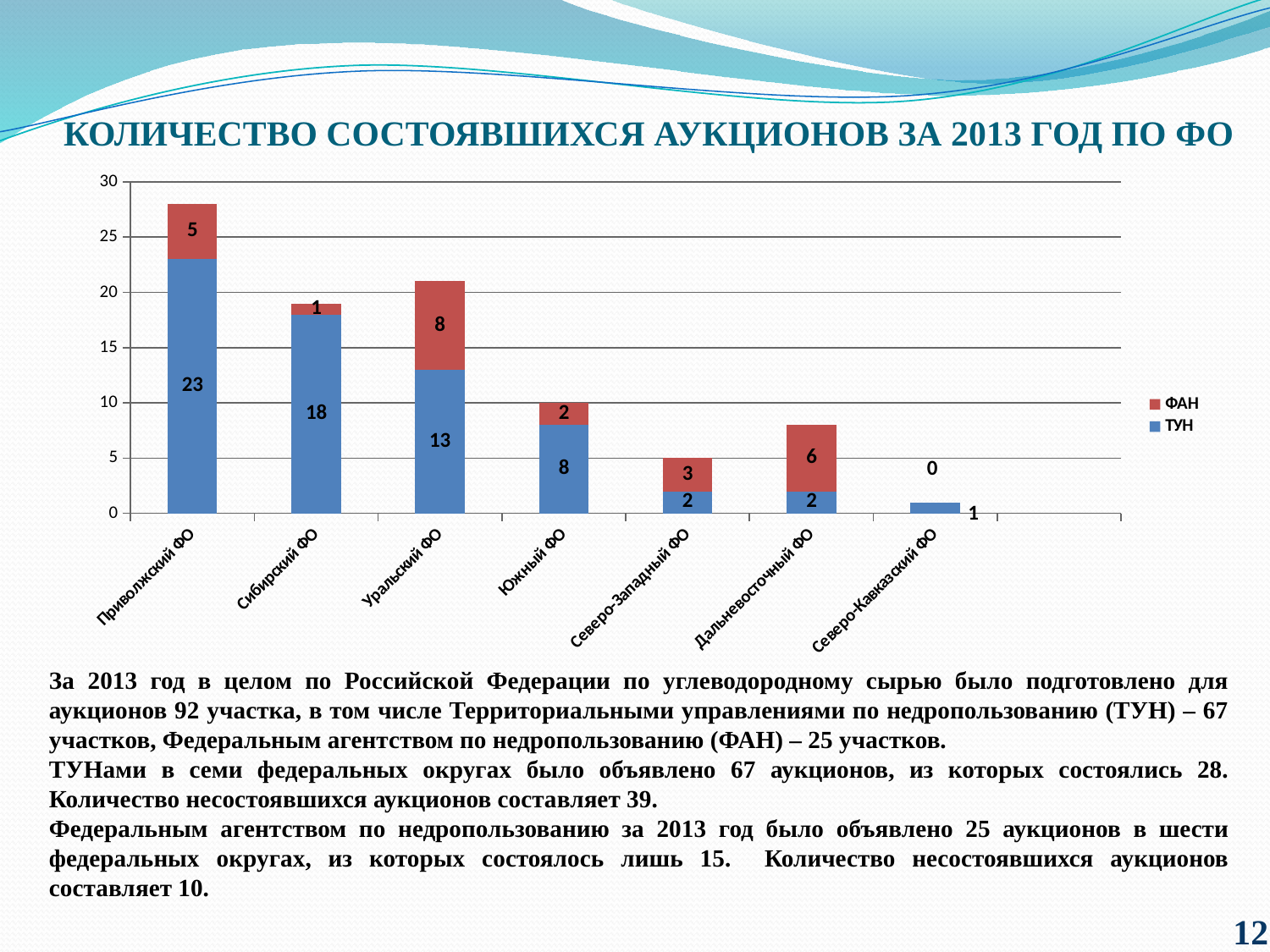
What is the ТУН value for Приволжский ФО? 23 Which federal district has the lowest ФАН value? Северо-Кавказский ФО Which is larger, the ФАН value for Дальневосточный ФО or the ФАН value for Южный ФО? Дальневосточный ФО What is the ФАН value for Уральский ФО? 8 What is the total of the stacked bar for Уральский ФО? 21 What is the ТУН value for Дальневосточный ФО? 2 Which federal district has the highest ТУН value? Приволжский ФО How many federal districts are shown on the x axis? 7 What is the difference between the ТУН values for Приволжский ФО and Сибирский ФО? 5 How many series does the legend list? 2 What kind of chart is shown on the slide? Stacked bar chart What is the ФАН value for Северо-Кавказский ФО? 0